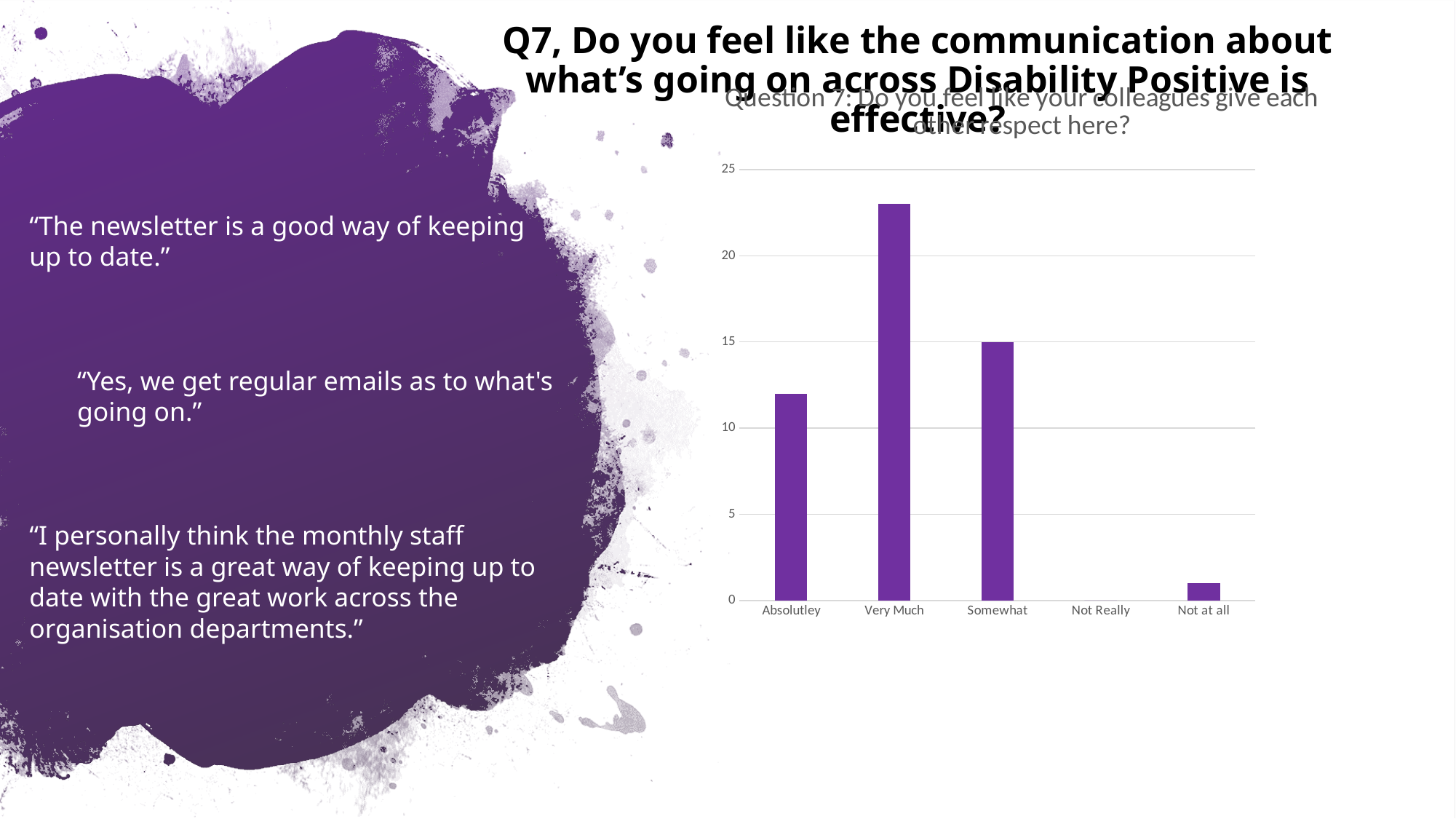
Is the value for Absolutley greater or less than 15? less What is the value for Somewhat in the chart? 15 Which category has the lowest value in the chart? Not Really Which is larger, the value for Very Much or the value for Somewhat? Very Much What colour are the bars in the chart? purple Is the value for Very Much greater or less than 20? greater What kind of chart is shown on the slide? bar chart Is the value for Absolutley greater or less than 10? greater Which is larger, the value for Absolutley or the value for Somewhat? Somewhat Which category has the highest bar in the chart? Very Much How many categories are shown on the x axis of the chart? 5